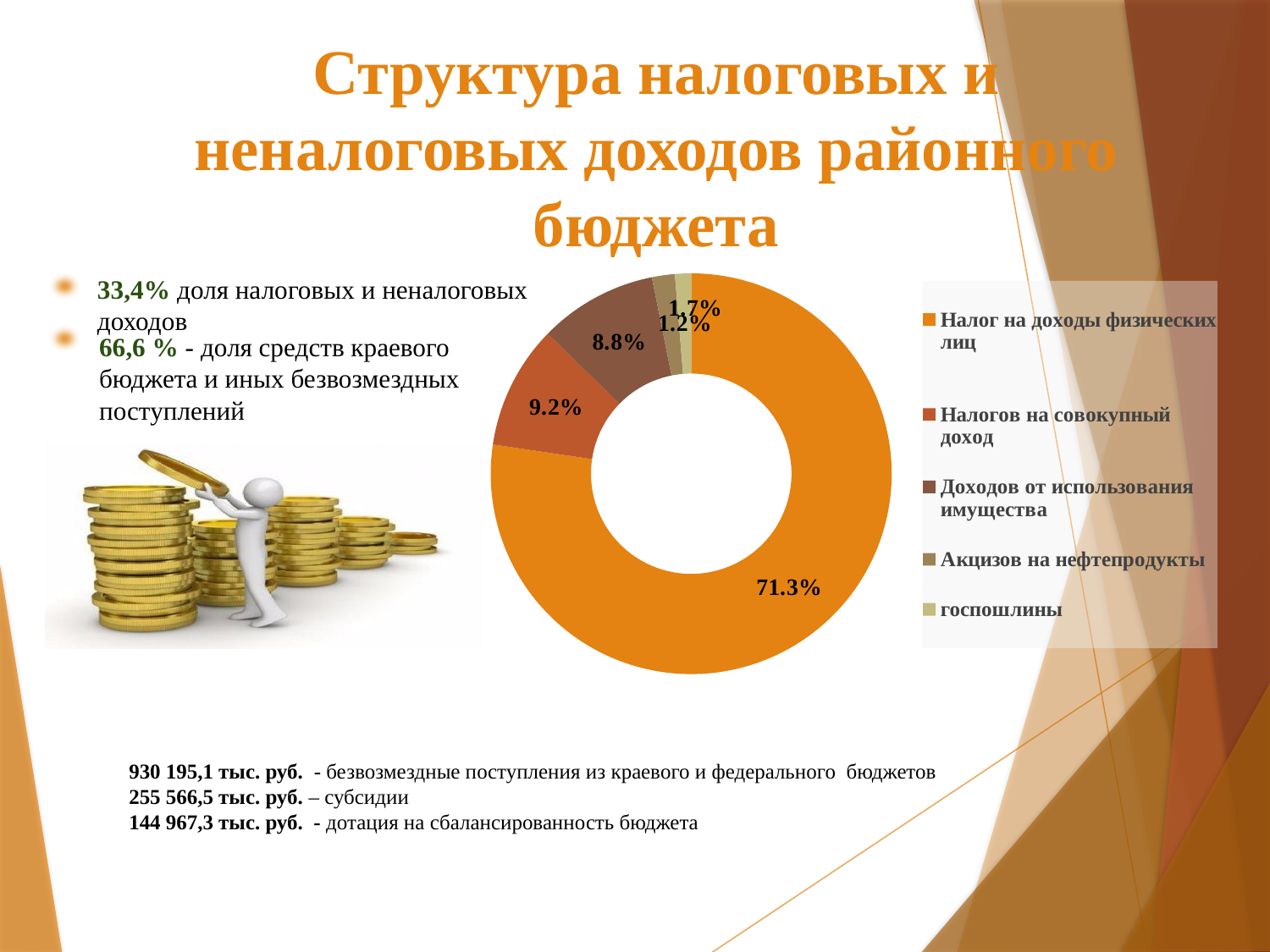
Is the share of "Налог на доходы физических лиц" greater or less than 50%? greater What is the difference between the shares of "Налог на доходы физических лиц" and "Налогов на совокупный доход"? 62.1% What colour is the largest slice of the chart? Orange How many categories does the chart's legend list? 5 What share does "Доходов от использования имущества" have in the chart? 8.8% What share does "Налогов на совокупный доход" have in the chart? 9.2% What kind of chart is shown on the slide? Doughnut (pie) chart Which is larger: the share of "Налогов на совокупный доход" or "Доходов от использования имущества"? Налогов на совокупный доход What share does "Налог на доходы физических лиц" have in the chart? 71.3% What is the difference between the shares of "Налогов на совокупный доход" and "Доходов от использования имущества"? 0.4% What is the smallest percentage label shown on the chart? 1.2% Which category has the largest slice in the chart? Налог на доходы физических лиц